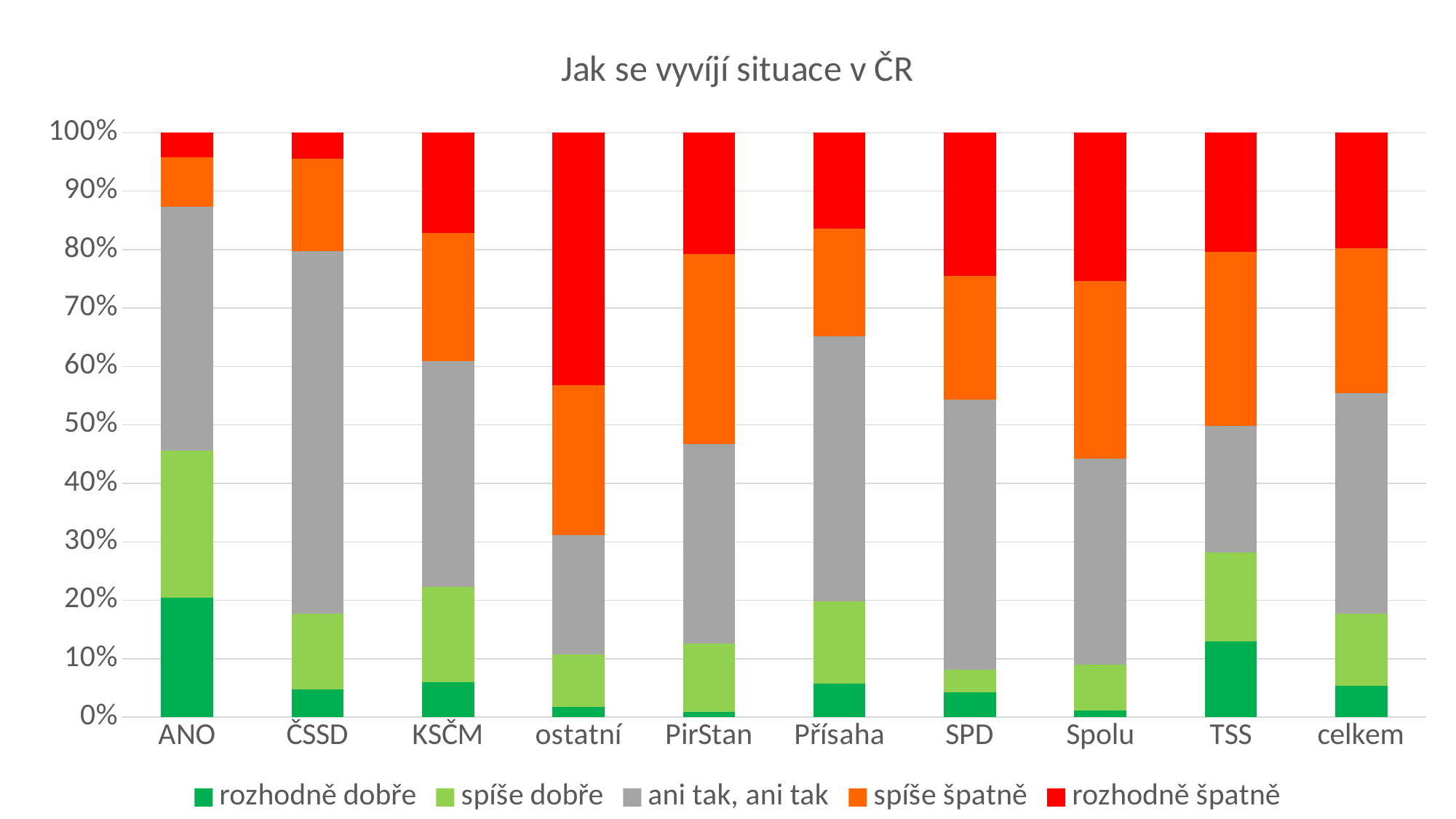
What colour represents the 'rozhodně špatně' series in the legend? red Which category has the largest 'rozhodně dobře' share? ANO What kind of chart is shown on the slide? stacked bar chart Which category has the largest 'rozhodně špatně' share? ostatní How many categories are shown on the x axis of the chart? 10 Is the 'rozhodně špatně' value for ostatní greater or less than 30%? greater What is the title of the chart? Jak se vyvíjí situace v ČR Which category has the largest 'ani tak, ani tak' share? ČSSD Is the 'rozhodně dobře' value for ANO greater or less than 10%? greater Is the 'rozhodně dobře' value for Spolu greater or less than 10%? less Which is larger, the 'rozhodně dobře' share for ANO or for TSS? ANO How many series does the legend list? 5